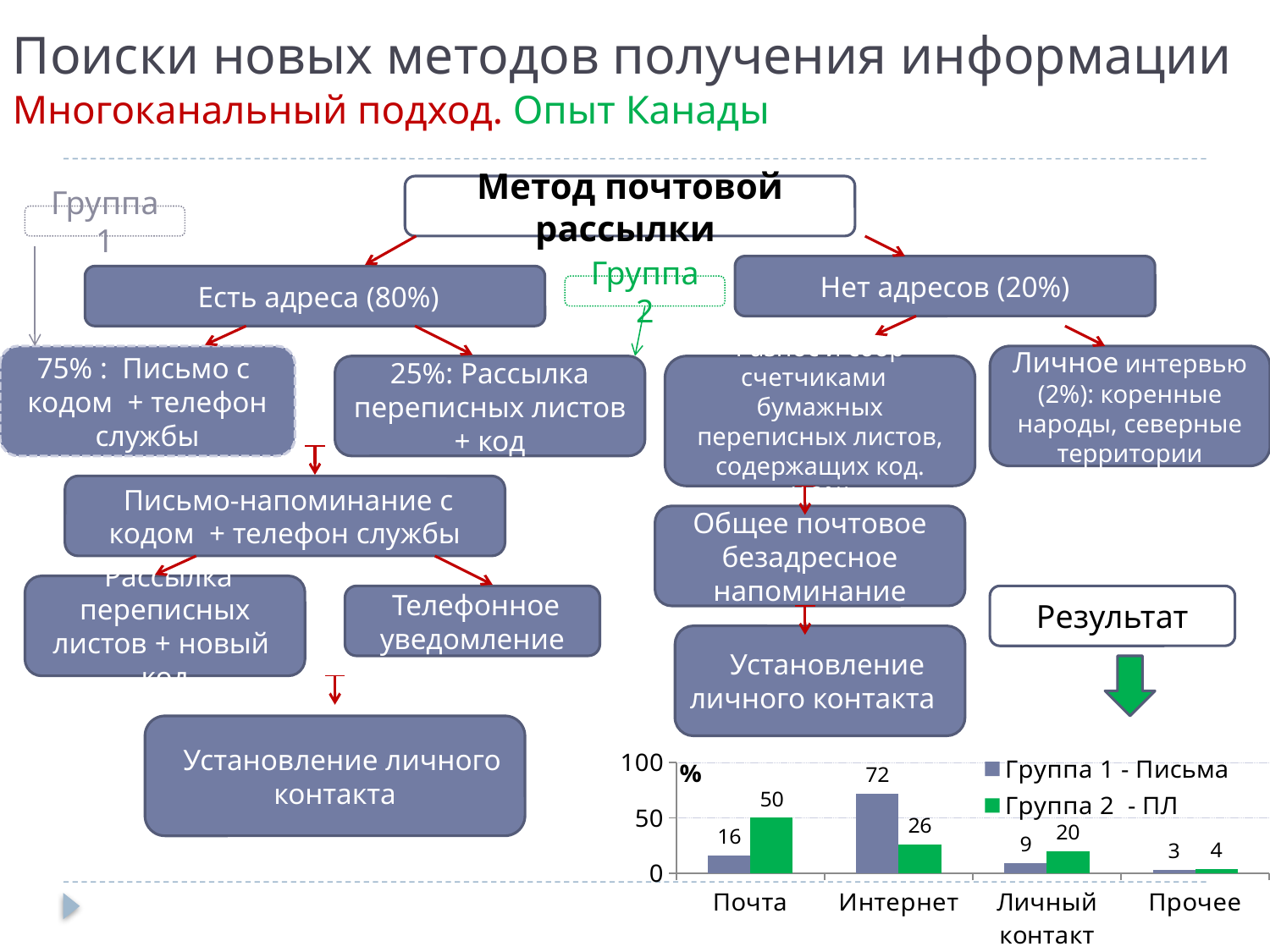
In the bar chart, what is the value for Группа 1 - Письма in the Интернет category? 72 In the bar chart, what is the value for Группа 2 - ПЛ in the Почта category? 50 In the bar chart, which category has the highest value for Группа 1 - Письма? Интернет How many categories are shown on the x axis of the bar chart? 4 In the bar chart, which series has the larger value in the Почта category? Группа 2 - ПЛ In the bar chart, is the value for Группа 1 - Письма in the Интернет category greater or less than 50? greater How many series does the legend of the bar chart list? 2 In the bar chart, what is the value for Группа 1 - Письма in the Личный контакт category? 9 What type of chart is shown at the bottom right of the slide? bar chart In the bar chart, what is the difference between Группа 1 - Письма and Группа 2 - ПЛ in the Интернет category? 46 In the bar chart, what is the value for Группа 2 - ПЛ in the Прочее category? 4 In the bar chart, which category has the lowest value for Группа 2 - ПЛ? Прочее